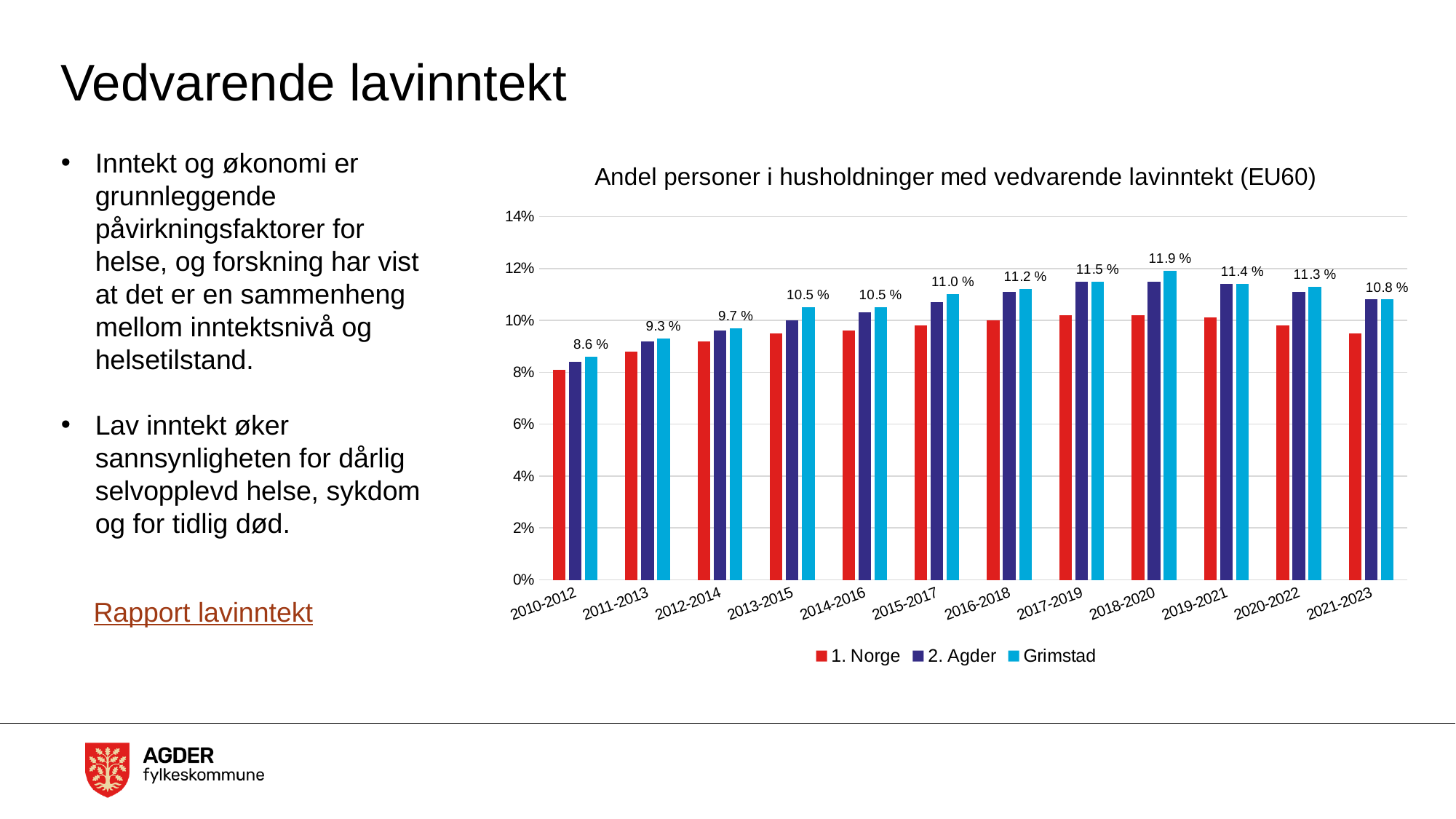
What is the value for Grimstad in 2018-2020? 11.9 % What is the value for Grimstad in 2010-2012? 8.6 % Is the value for 1. Norge in 2021-2023 greater or less than 10%? less Which is larger for Grimstad: the value for 2017-2019 or the value for 2020-2022? 2017-2019 What kind of chart is shown on the slide? Bar chart In which period is the Grimstad value highest? 2018-2020 Is the value for 2. Agder in 2018-2020 greater or less than 10%? greater How many series does the legend list? 3 In which period is the Grimstad value lowest? 2010-2012 What is the difference between the Grimstad values for 2018-2020 and 2010-2012? 3.3 percentage points What is the value for Grimstad in 2021-2023? 10.8 % How many periods are shown on the x axis? 12